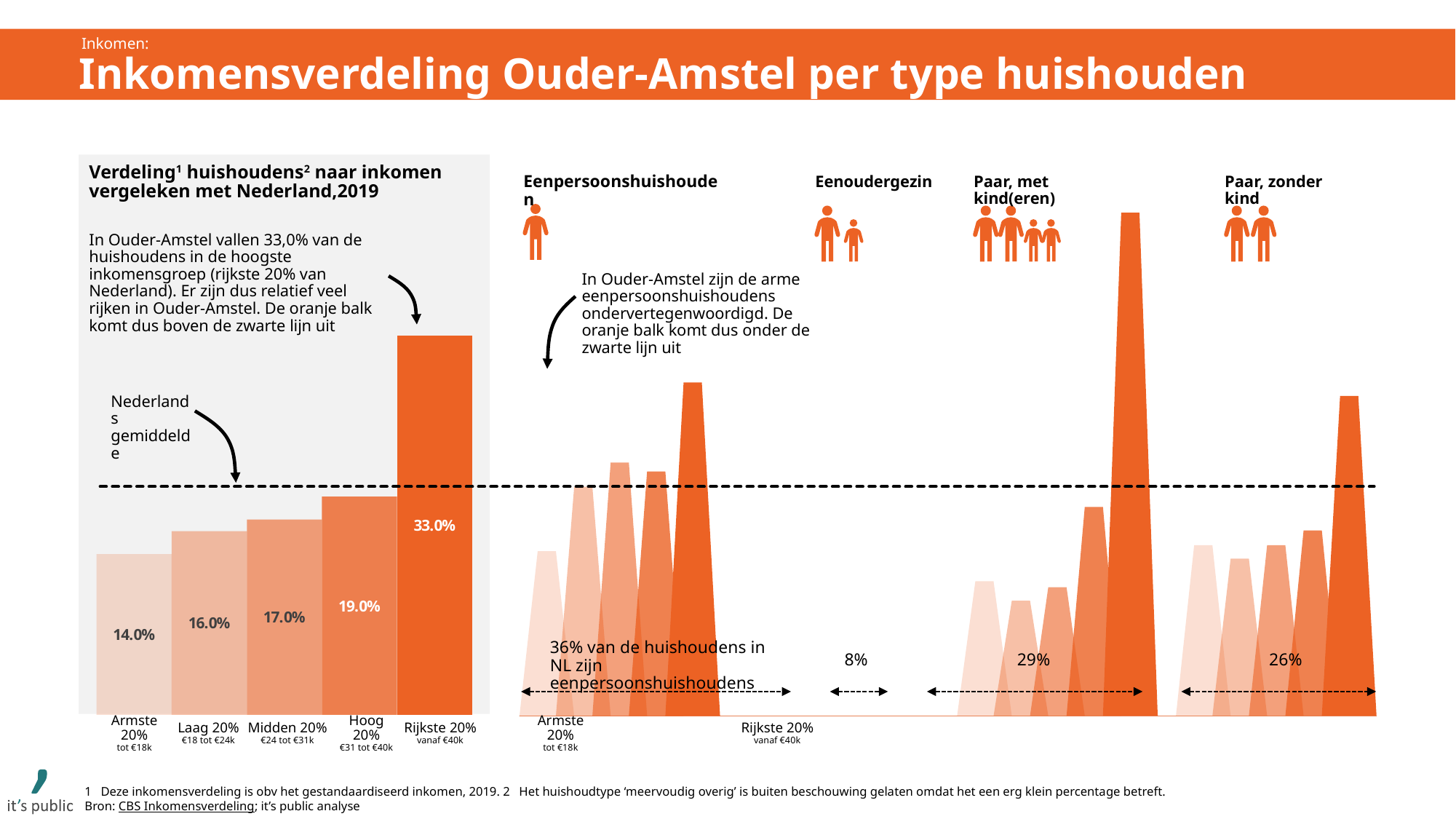
In the right-hand chart, what share of households in the Netherlands are Eenoudergezin? 8% In the left chart, what is the difference between the values for Rijkste 20% and Hoog 20%? 14.0% What kind of chart is the left chart 'Verdeling huishoudens naar inkomen vergeleken met Nederland, 2019'? bar chart In the left chart, which income group has the highest value? Rijkste 20% In the left chart, what is the value for Armste 20%? 14.0% In the left chart, which is larger: the value for Laag 20% or the value for Hoog 20%? Hoog 20% How many income groups are shown in the left chart? 5 In the left chart 'Verdeling huishoudens naar inkomen vergeleken met Nederland, 2019', what is the value for Rijkste 20%? 33.0% In the left chart, what is the value for Midden 20%? 17.0% In the left chart, do the values rise or fall from Armste 20% to Rijkste 20%? rise In the left chart, what does the dashed horizontal line represent? Nederlands gemiddelde In the left chart, which income group has the lowest value? Armste 20%